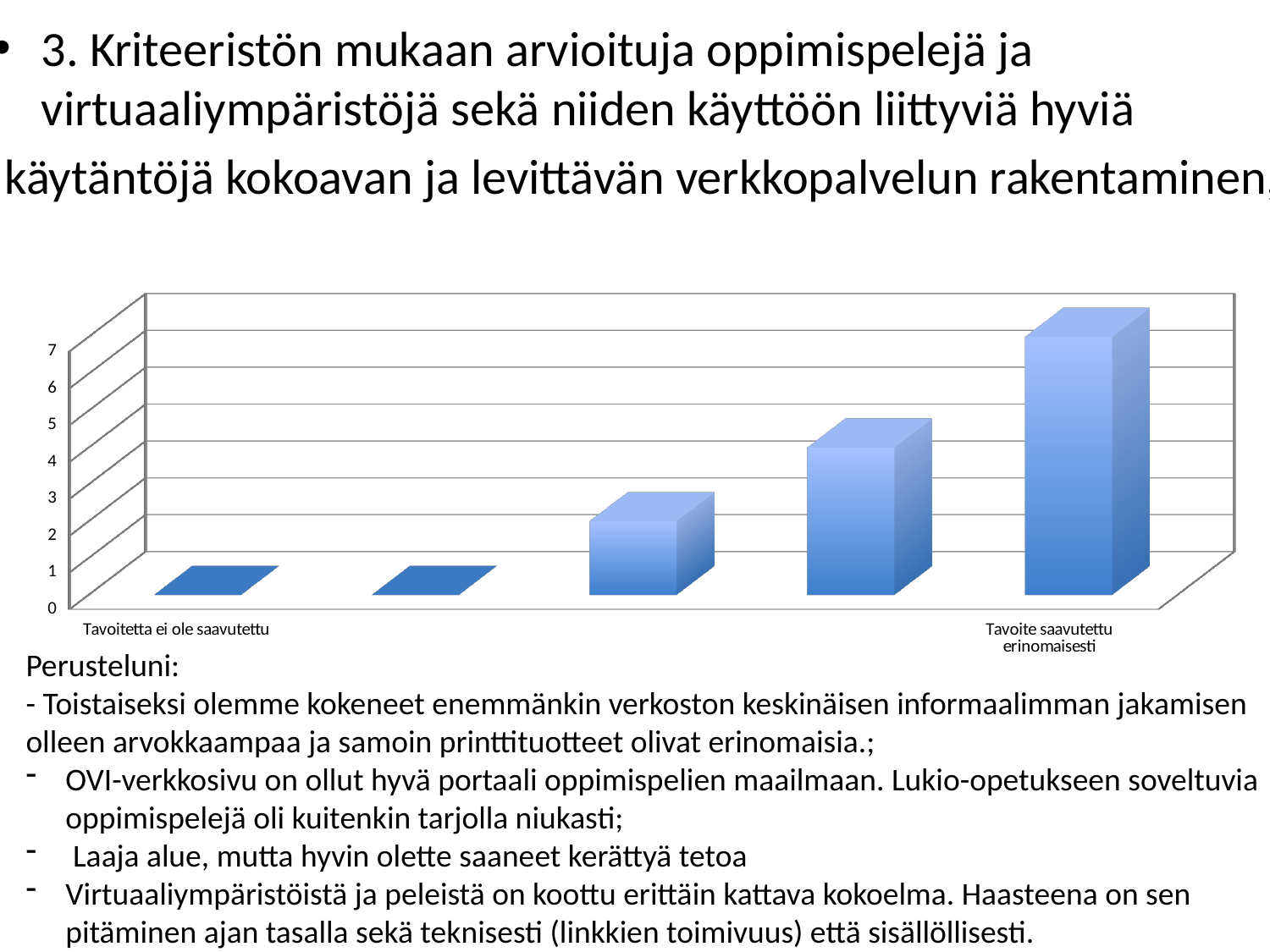
Is the value of the fourth bar greater or less than 3? greater Which category has the highest bar? Tavoite saavutettu erinomaisesti Is the value of the fourth bar greater or less than 5? less Do the bar values rise or fall from left to right along the x axis? rise What is the label of the leftmost category on the x axis? Tavoitetta ei ole saavutettu Is the value for "Tavoitetta ei ole saavutettu" greater or less than 1? less Which is larger, the value for "Tavoite saavutettu erinomaisesti" or the value for "Tavoitetta ei ole saavutettu"? Tavoite saavutettu erinomaisesti What kind of chart is shown on the slide? bar chart How many bars does the chart contain? 5 What is the highest value shown on the vertical axis? 7